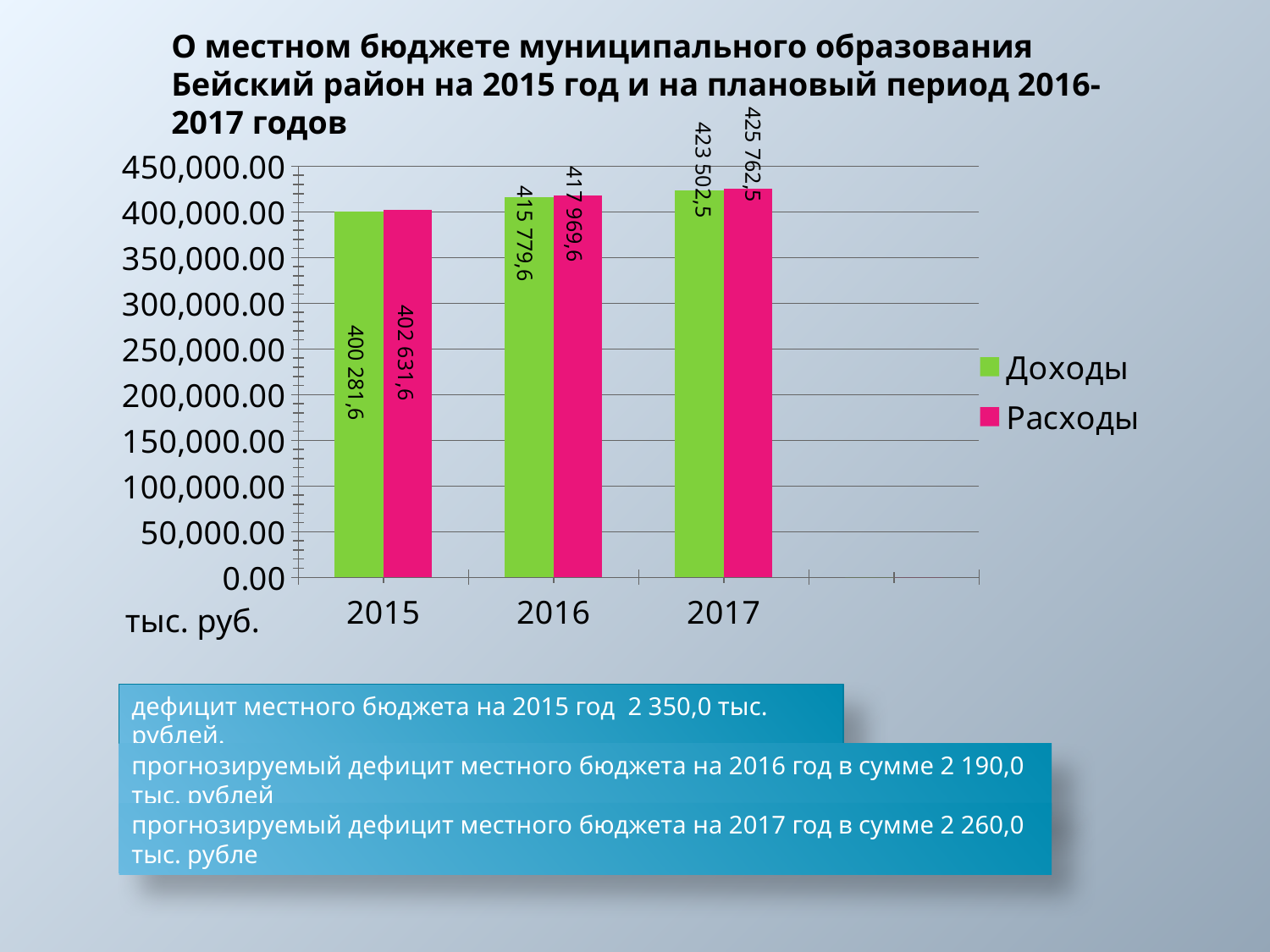
Do the Доходы values rise or fall from 2015 to 2017? rise What is the difference between Расходы and Доходы in 2015? 2 350,0 How many series does the legend list? 2 In which year is Расходы the lowest? 2015 Which is larger in 2016, Доходы or Расходы? Расходы Is the value of Доходы for 2015 greater or less than 350,000.00? greater What is the value of Доходы for 2016? 415 779,6 In which year is Доходы the highest? 2017 What is the value of Расходы for 2017? 425 762,5 What is the difference between Расходы and Доходы in 2017? 2 260,0 What is the value of Доходы for 2015? 400 281,6 What is the value of Расходы for 2016? 417 969,6